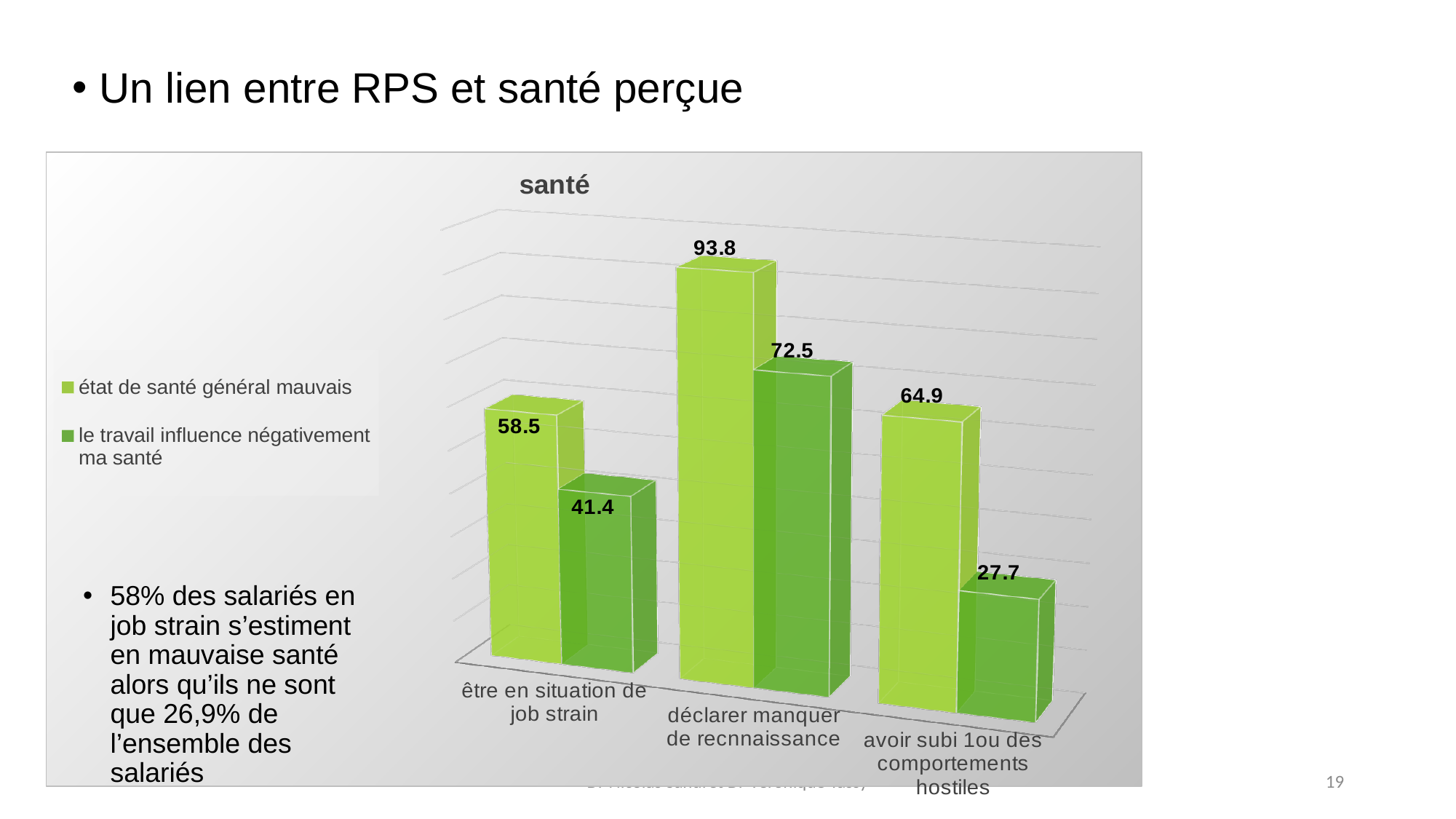
What is the value of 'le travail influence négativement ma santé' for 'déclarer manquer de recnnaissance'? 72.5 What is the difference between the two series for 'être en situation de job strain'? 17.1 What is the value of 'état de santé général mauvais' for 'être en situation de job strain'? 58.5 How many series does the legend list? 2 What is the title of the chart? santé Which category has the lowest value for 'le travail influence négativement ma santé'? avoir subi 1ou des comportements hostiles How many categories are shown on the x axis? 3 Which category has the highest value for 'état de santé général mauvais'? déclarer manquer de recnnaissance What is the value of 'le travail influence négativement ma santé' for 'avoir subi 1ou des comportements hostiles'? 27.7 What is the difference between 'état de santé général mauvais' for 'déclarer manquer de recnnaissance' and for 'avoir subi 1ou des comportements hostiles'? 28.9 What kind of chart is shown? bar chart Which is larger: 'le travail influence négativement ma santé' for 'être en situation de job strain' or for 'avoir subi 1ou des comportements hostiles'? être en situation de job strain